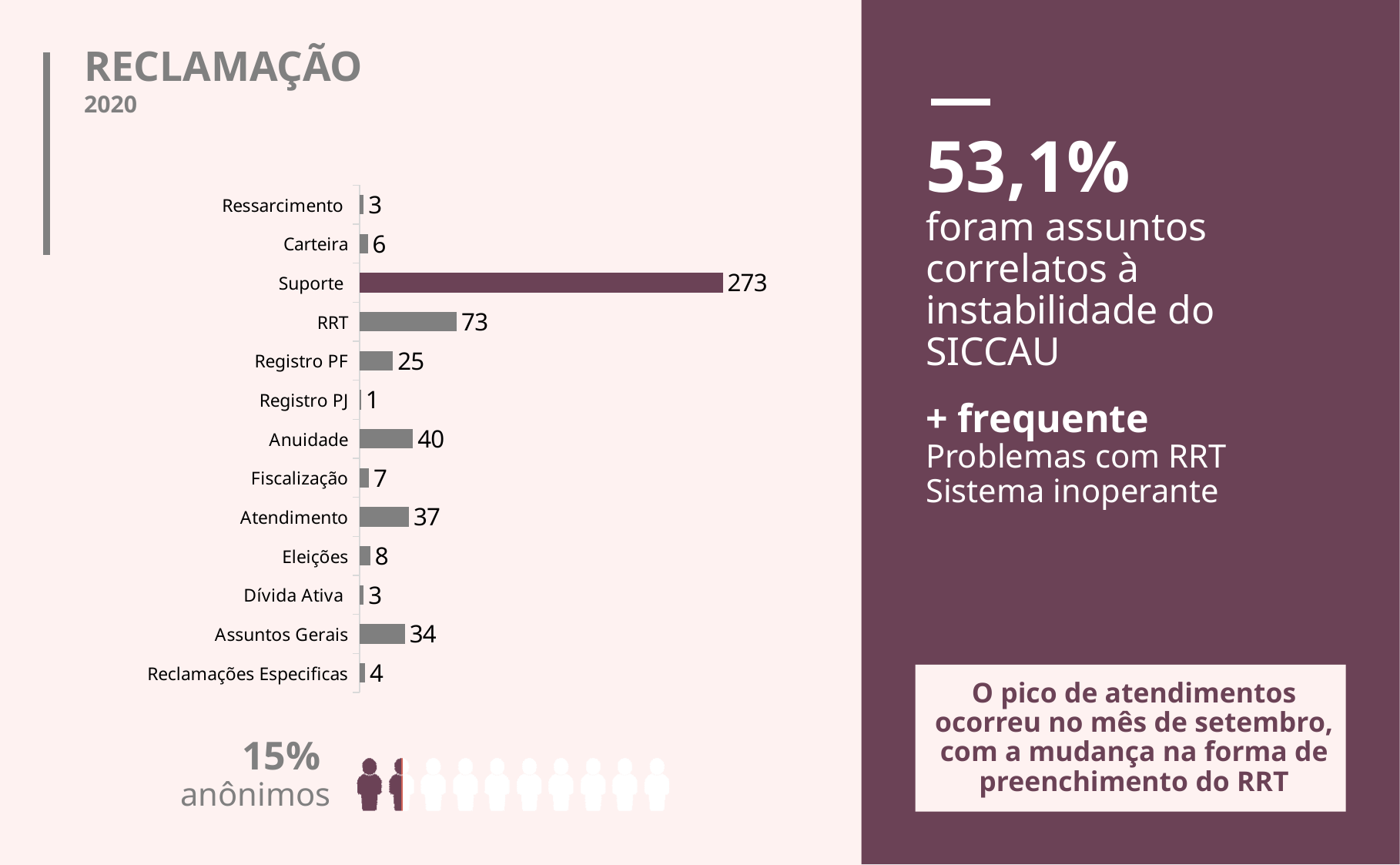
What kind of chart is shown on the slide? Bar chart What is the difference between the values for Suporte and RRT? 200 What is the value for RRT? 73 Which category has the highest value? Suporte Which bar is drawn in a different colour from the others? Suporte What is the value for Registro PF? 25 Which category has the lowest value? Registro PJ What is the value for Suporte? 273 Which is larger, the value for Assuntos Gerais or the value for Registro PF? Assuntos Gerais What is the difference between the values for Anuidade and Atendimento? 3 What is the value for Anuidade? 40 How many categories are shown in the chart? 13